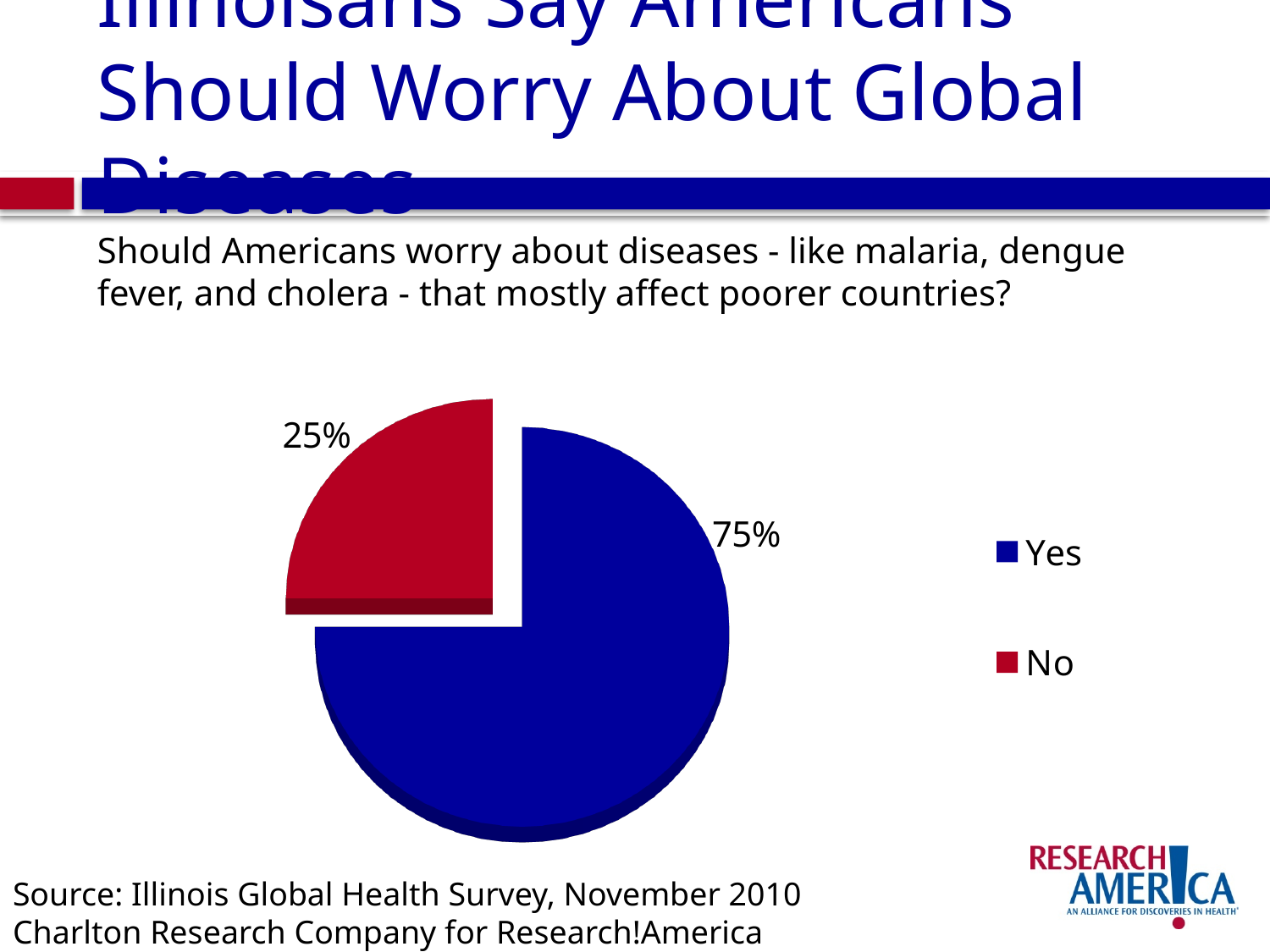
How many slices does the pie chart have? 2 Which response has the largest share of the pie? Yes Which response has the smallest share of the pie? No What is the difference in percentage points between the Yes and No responses? 50 Is the value for Yes greater or less than 50%? greater What percentage of respondents answered Yes? 75% What colour is the slice representing No? Red What percentage of respondents answered No? 25% How many entries does the legend list? 2 Which is larger, the share for Yes or the share for No? Yes What kind of chart is shown on the slide? Pie chart Which slice is pulled out from the rest of the pie? No